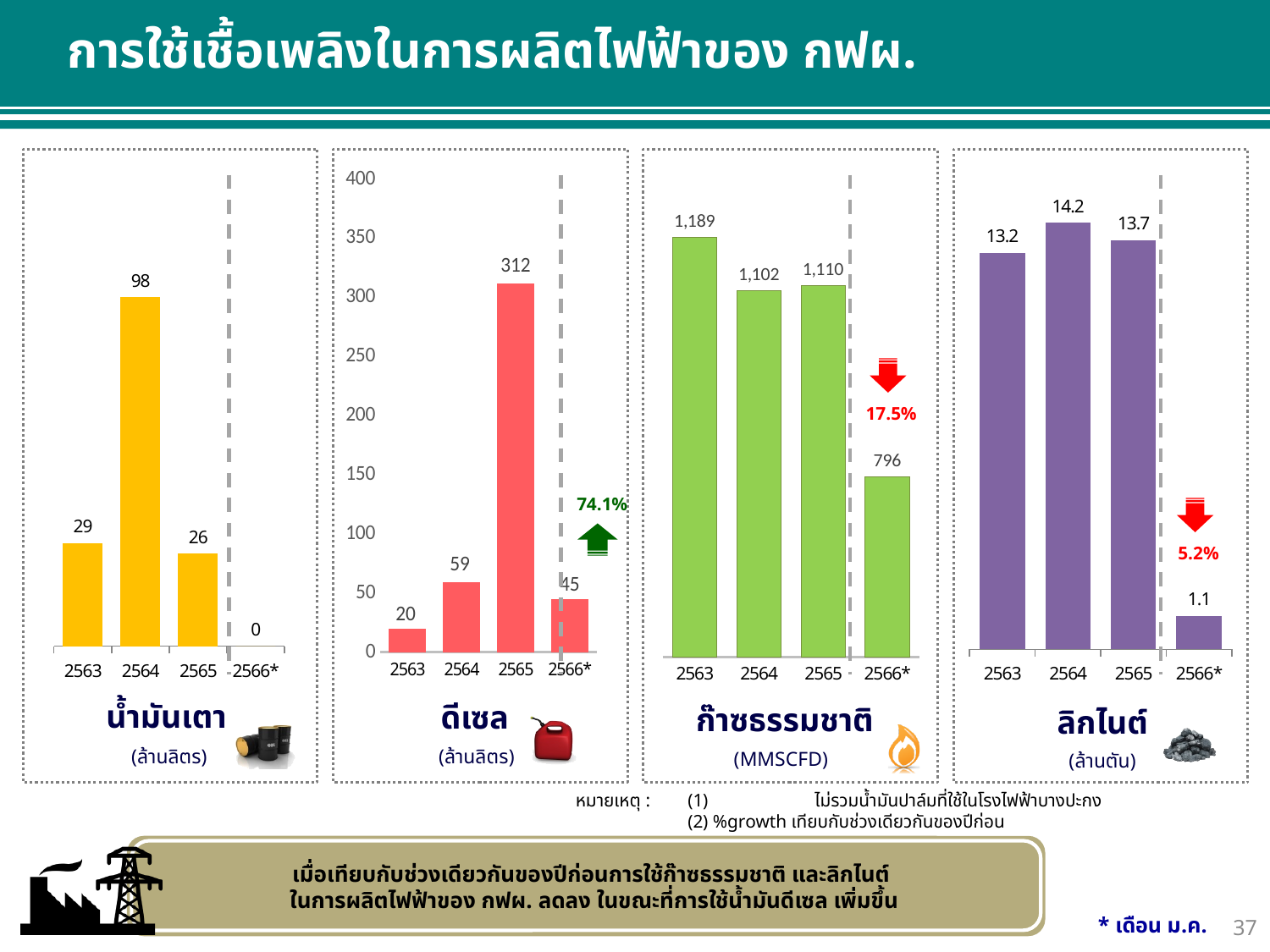
In the ก๊าซธรรมชาติ chart, what is the difference between the values for 2563 and 2566*? 393 In the ลิกไนต์ chart, what is the value for 2564? 14.2 In the ดีเซล chart, which year has the highest value? 2565 In the น้ำมันเตา chart, what is the value for 2564? 98 What kind of chart is the ดีเซล chart? bar chart How many years are shown on the x axis of the ลิกไนต์ chart? 4 In the ก๊าซธรรมชาติ chart, what is the value for 2566*? 796 In the ดีเซล chart, what is the value for 2565? 312 In the น้ำมันเตา chart, which year has the lowest value? 2566* In the ลิกไนต์ chart, which year has the lowest value? 2566* In the ก๊าซธรรมชาติ chart, which is larger, the value for 2563 or the value for 2564? 2563 In the ดีเซล chart, what is the difference between the values for 2565 and 2564? 253